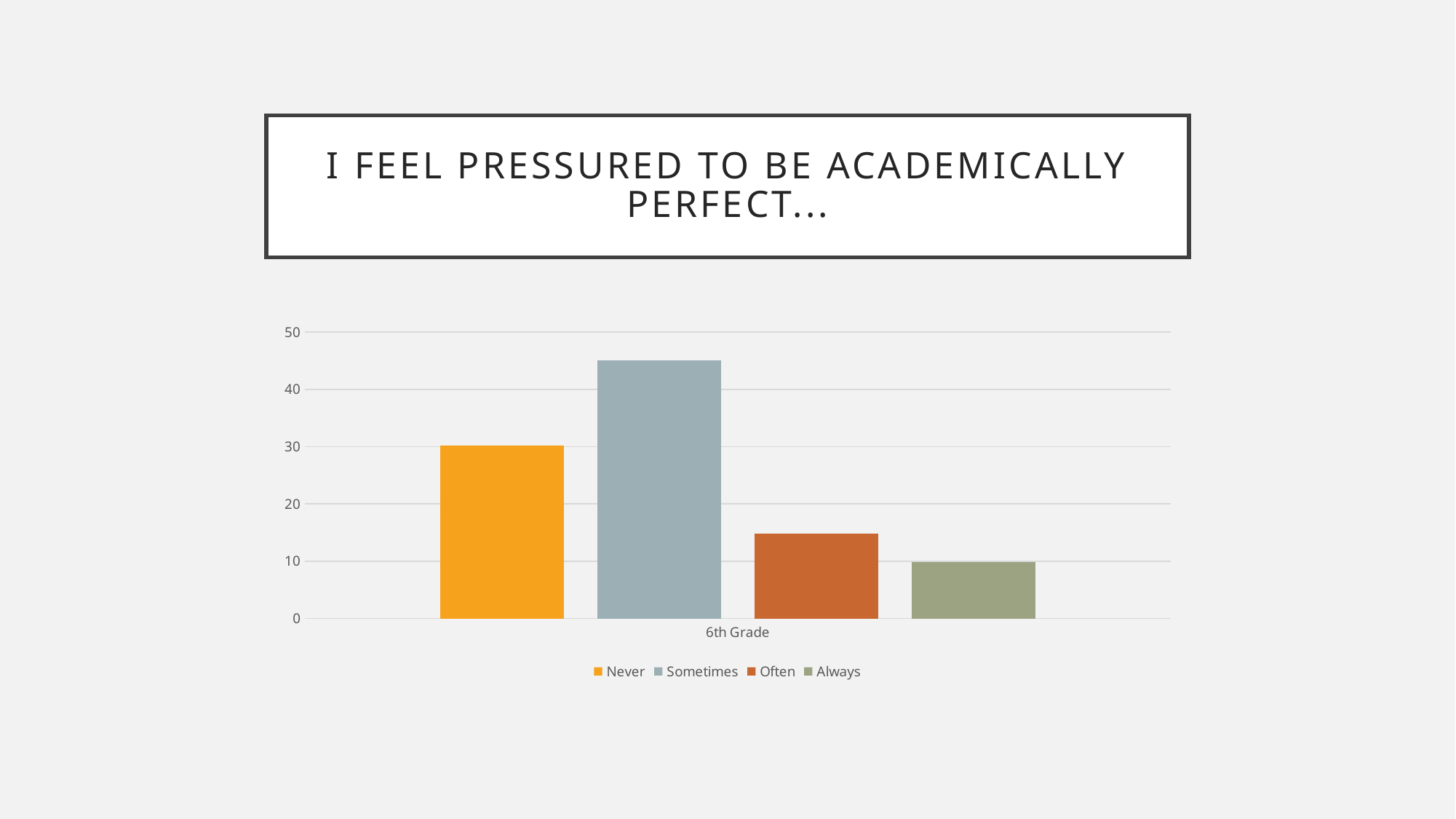
What kind of chart is shown on the slide? bar chart Is the value for Never greater or less than 20? greater What is the category label on the x axis? 6th Grade Is the value for Often greater or less than 20? less Which series has the highest value for 6th Grade? Sometimes Which is larger, the value for Never or the value for Often? Never Which series has the lowest value for 6th Grade? Always How many categories are shown on the x axis? 1 What is the title of the slide above the chart? I FEEL PRESSURED TO BE ACADEMICALLY PERFECT... Is the value for Sometimes greater or less than 40? greater How many series does the legend list? 4